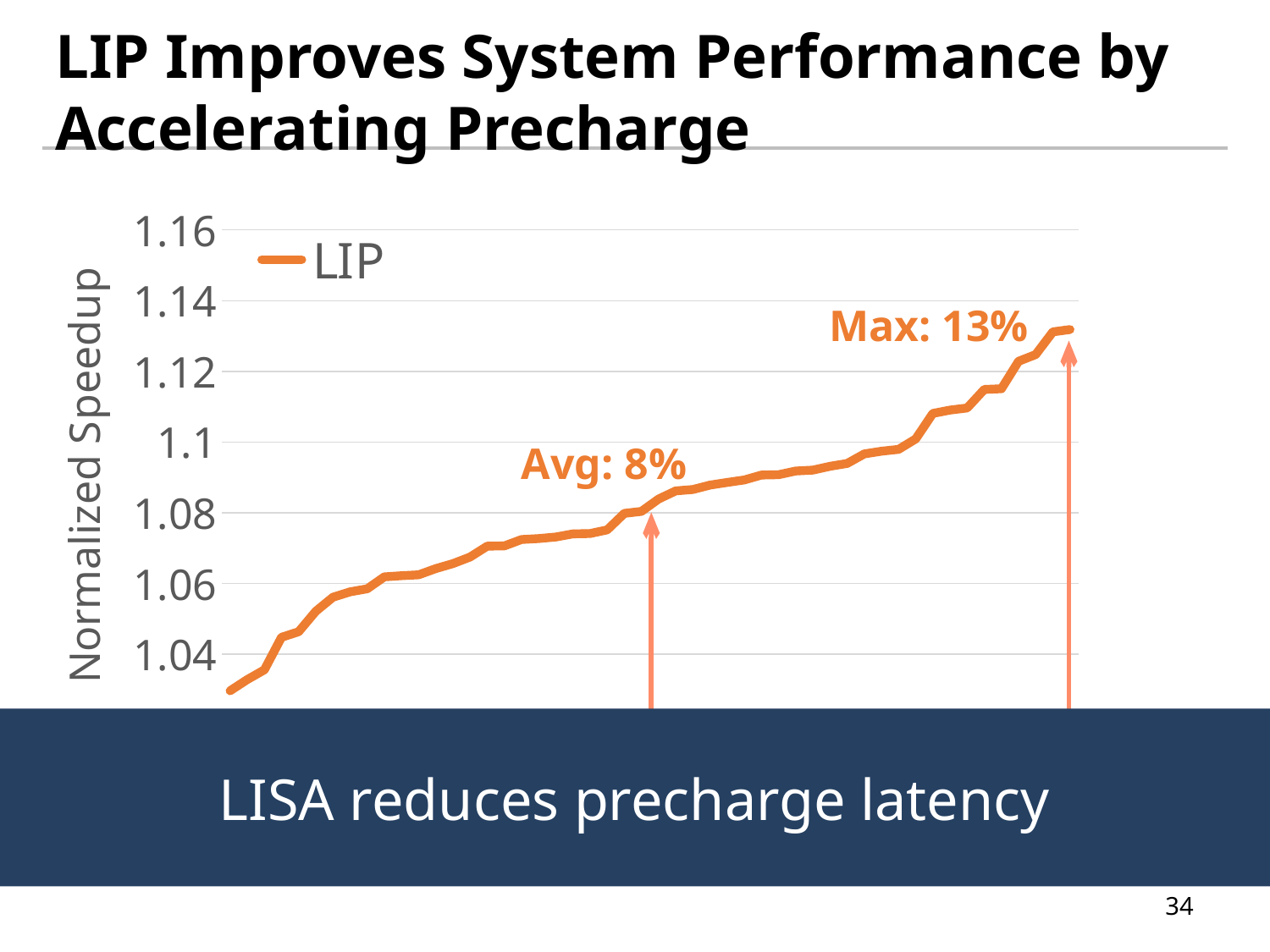
Is the point marked by the 'Avg: 8%' arrow greater or less than 1.06? greater What kind of chart is shown on the slide? line chart Is the lowest point of the LIP line greater or less than 1.04? less Do the values of the LIP line rise or fall along the x axis? rise Is the highest point of the LIP line greater or less than 1.12? greater What is the name of the series shown in the legend? LIP What is the label of the y axis? Normalized Speedup What average speedup is annotated on the chart? Avg: 8% What maximum speedup is annotated on the chart? Max: 13% How many series does the legend list? 1